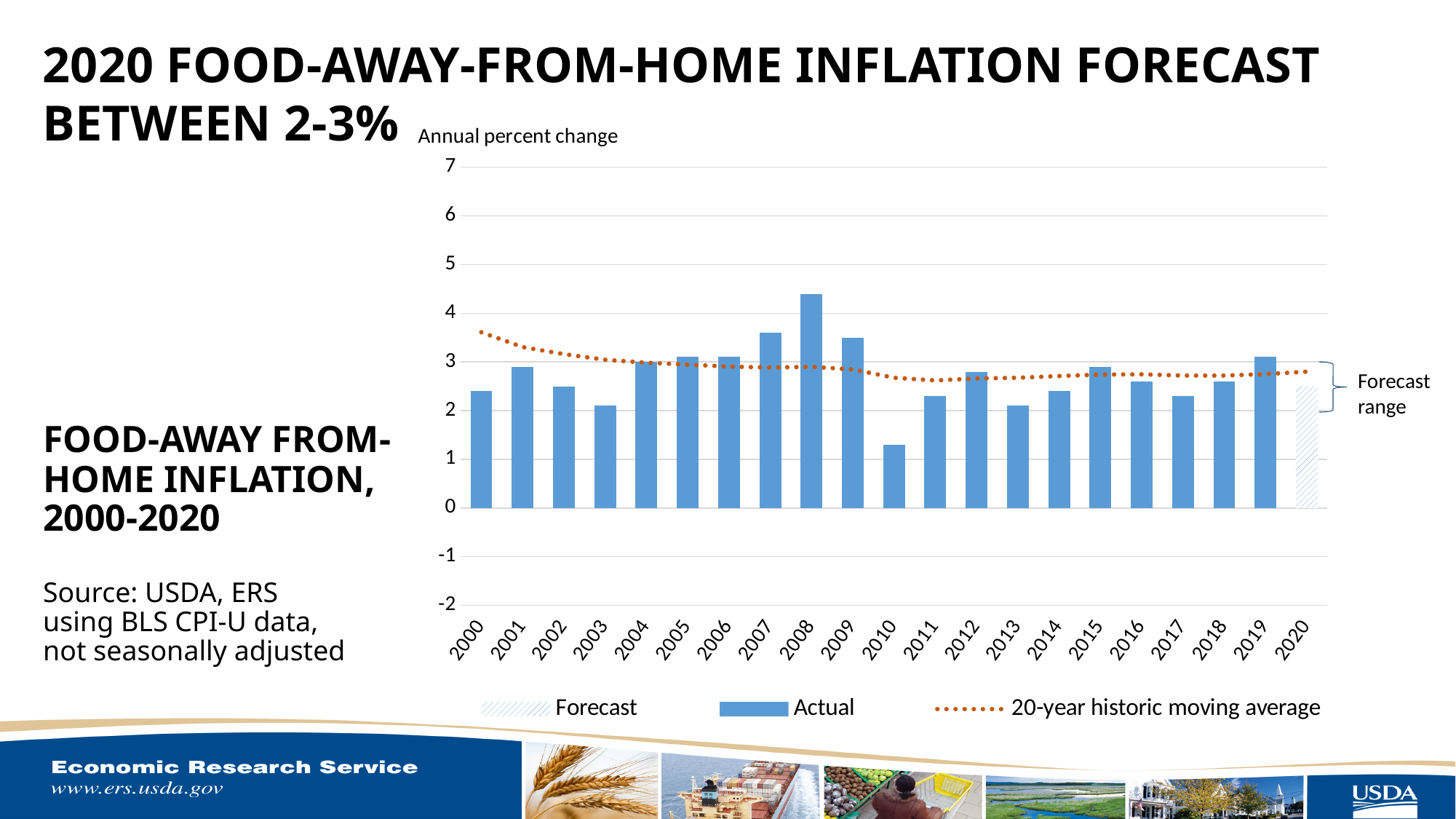
How many years are shown on the x axis? 21 Which year has the larger actual value, 2007 or 2011? 2007 What kind of chart is shown on the slide? Bar and line chart Which year has the lowest actual food-away-from-home inflation? 2010 Do the actual values rise or fall from 2008 to 2010? Fall Is the value for 2009 greater or less than 3? greater Which year has the highest actual food-away-from-home inflation? 2008 How many series does the legend list? 3 Is the value for 2000 greater or less than 2? greater Is the value for 2008 greater or less than 4? greater